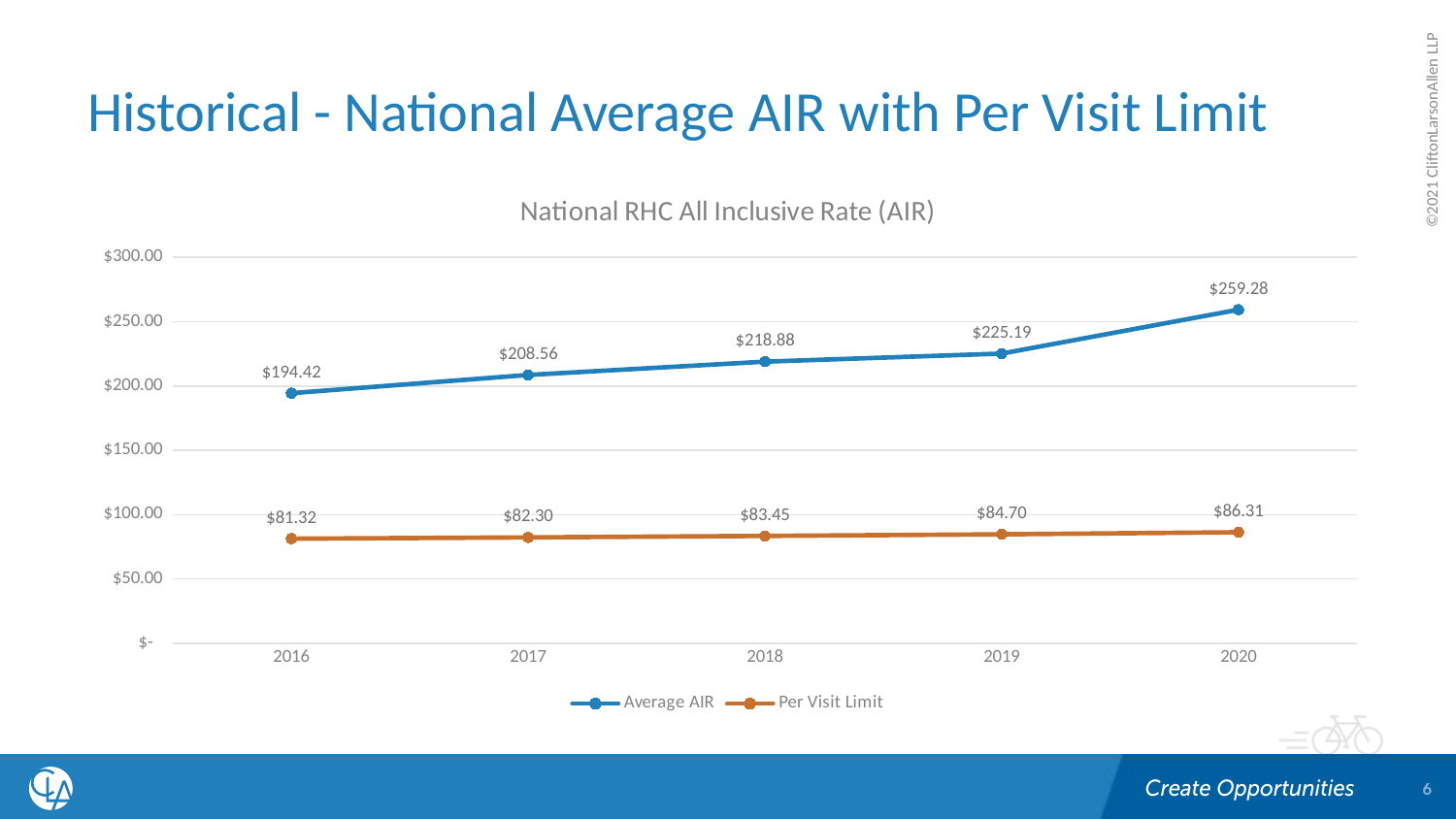
Which is larger in 2019: the Average AIR or the Per Visit Limit? Average AIR In which year is the Average AIR highest? 2020 How many series does the legend list? 2 What is the difference between the Average AIR and the Per Visit Limit in 2017? $126.26 What is the Per Visit Limit value for 2020? $86.31 How many years are shown on the x axis? 5 What is the Average AIR value for 2016? $194.42 In which year is the Per Visit Limit lowest? 2016 What is the difference between the Average AIR in 2020 and in 2019? $34.09 Is the Per Visit Limit for 2018 greater or less than $100.00? less What kind of chart is shown on the slide? line chart What is the Average AIR value for 2018? $218.88